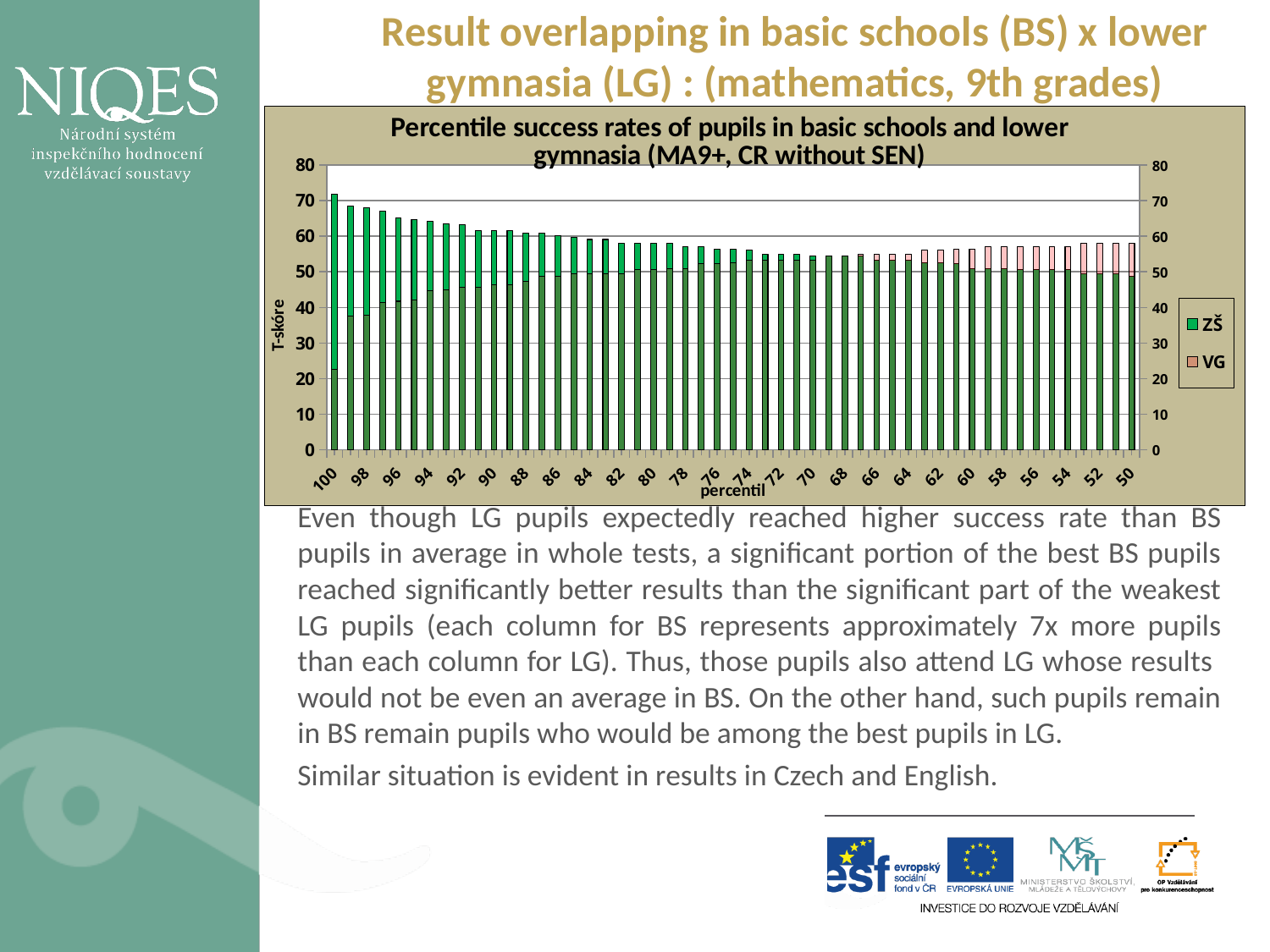
How many series does the chart legend list? 2 At percentile 50, which bar reaches higher, ZŠ or VG? VG What kind of chart is shown on the slide? bar chart What is the label of the vertical axis of the chart? T-skóre At percentile 100, is the top of the ZŠ bar greater or less than 50? greater Is the top of the ZŠ bar at percentile 100 greater or less than 60? greater Do the tops of the ZŠ bars rise or fall as the percentile goes from 100 to 50 along the x axis? fall Is the top of the ZŠ bar at percentile 50 greater or less than 60? less What are the two series named in the chart legend? ZŠ and VG